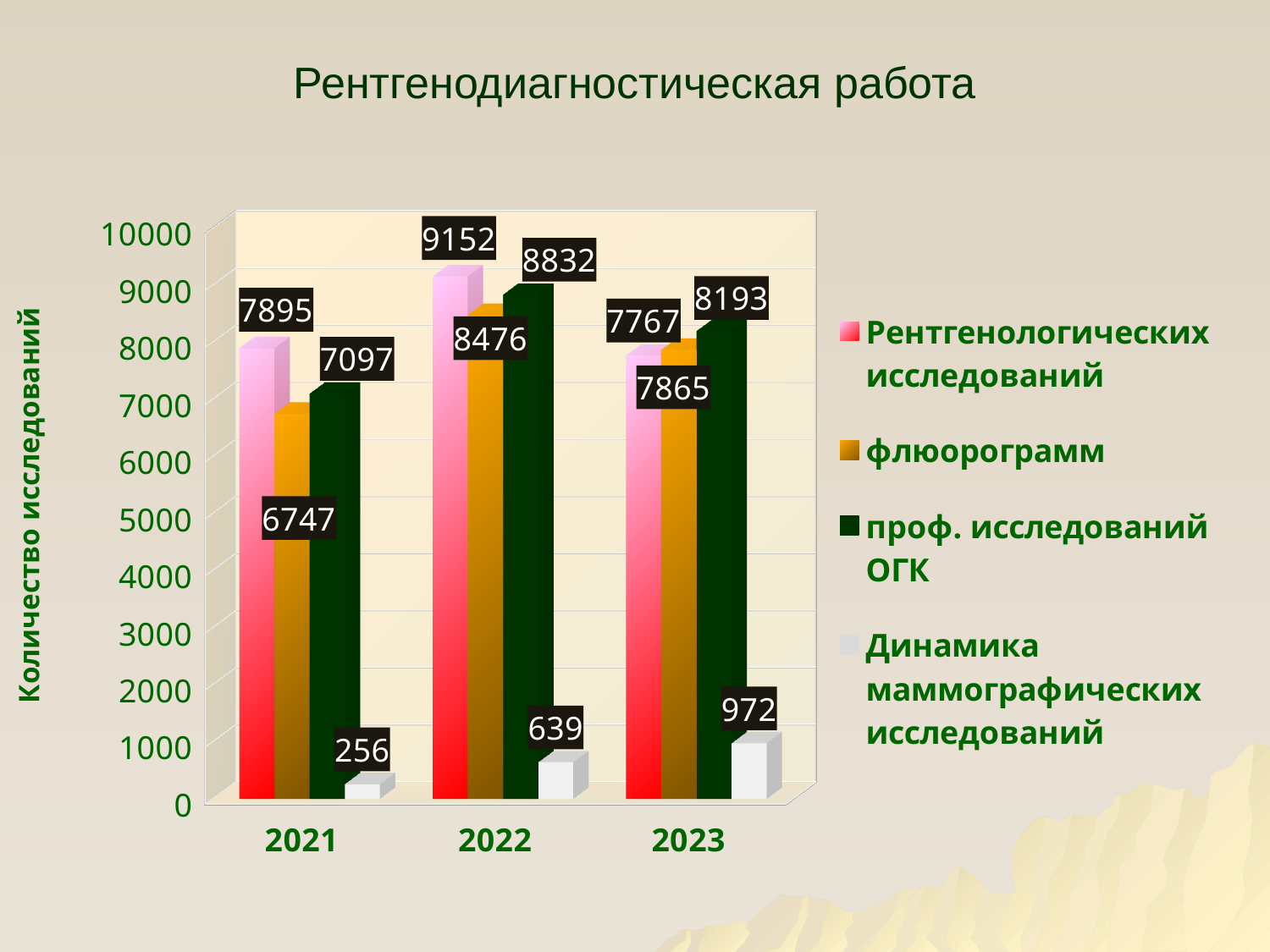
What type of chart is shown on the slide? bar chart Do the values for Динамика маммографических исследований rise or fall from 2021 to 2023? rise How many series does the legend list? 4 Which is larger in 2023: флюорограмм or проф. исследований ОГК? проф. исследований ОГК What is the value for проф. исследований ОГК in 2023? 8193 What is the difference between the Рентгенологических исследований values for 2022 and 2021? 1257 In which year is the value for Рентгенологических исследований highest? 2022 What is the value for Динамика маммографических исследований in 2021? 256 How many years are shown on the x axis? 3 What is the value for Рентгенологических исследований in 2022? 9152 In which year is the value for Динамика маммографических исследований lowest? 2021 What is the value for флюорограмм in 2021? 6747